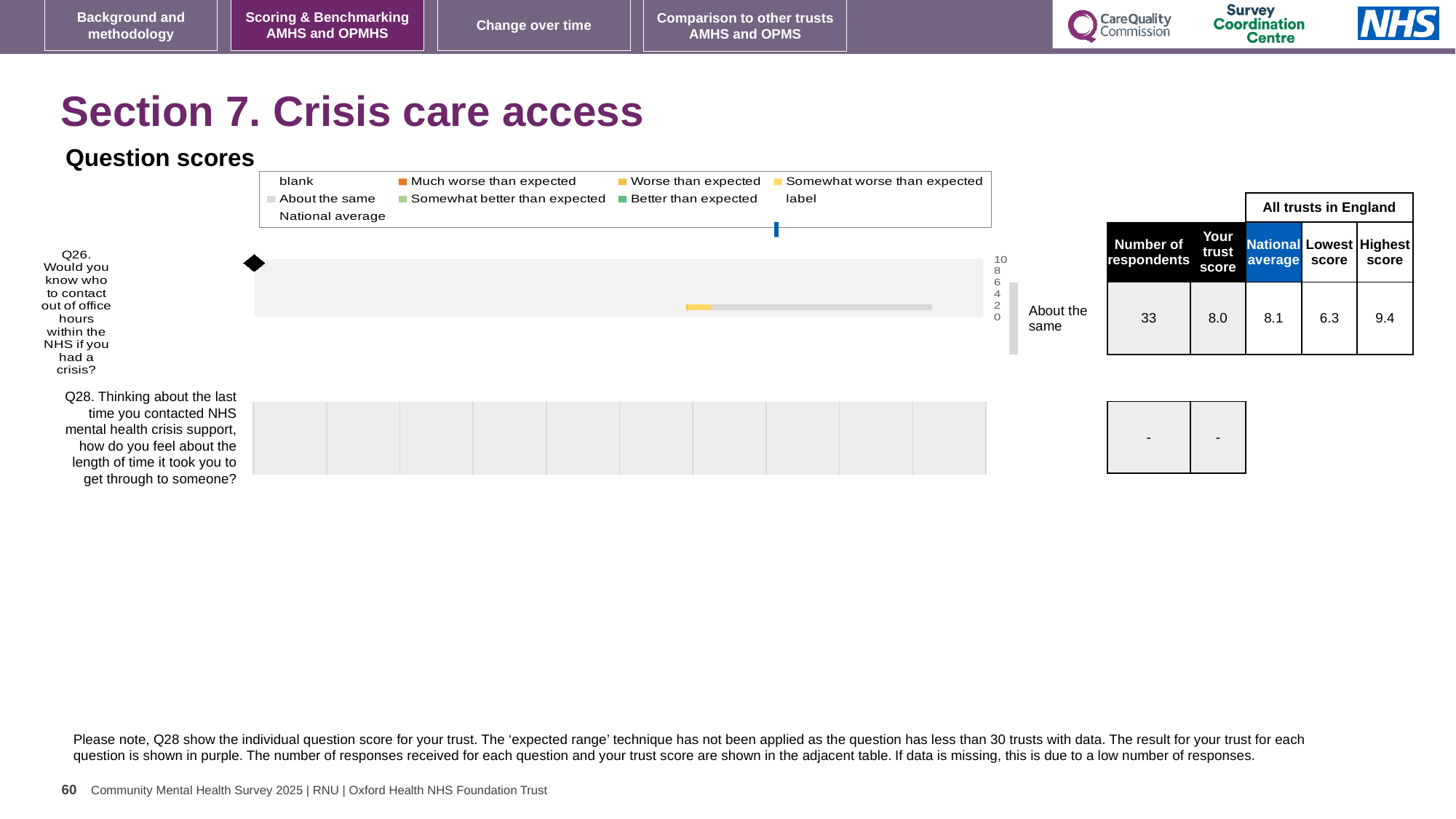
How many questions are plotted in the question scores chart? 2 What is the highest score across all trusts in England for Q26? 9.4 What is the difference between the highest score and the lowest score for Q26? 3.1 What kind of chart is used to show the question scores on this slide? bar chart What is shown as the trust score for Q28 in the table? - What is the national average for Q26 shown in the table next to the chart? 8.1 What is the maximum value shown on the chart's score axis? 10 How many respondents are recorded for Q26? 33 What is the trust score for Q26 shown in the table next to the chart? 8.0 For Q26, which is larger: the trust score or the national average? National average What category label is shown for Q26 in the chart? About the same What is the lowest score across all trusts in England for Q26? 6.3